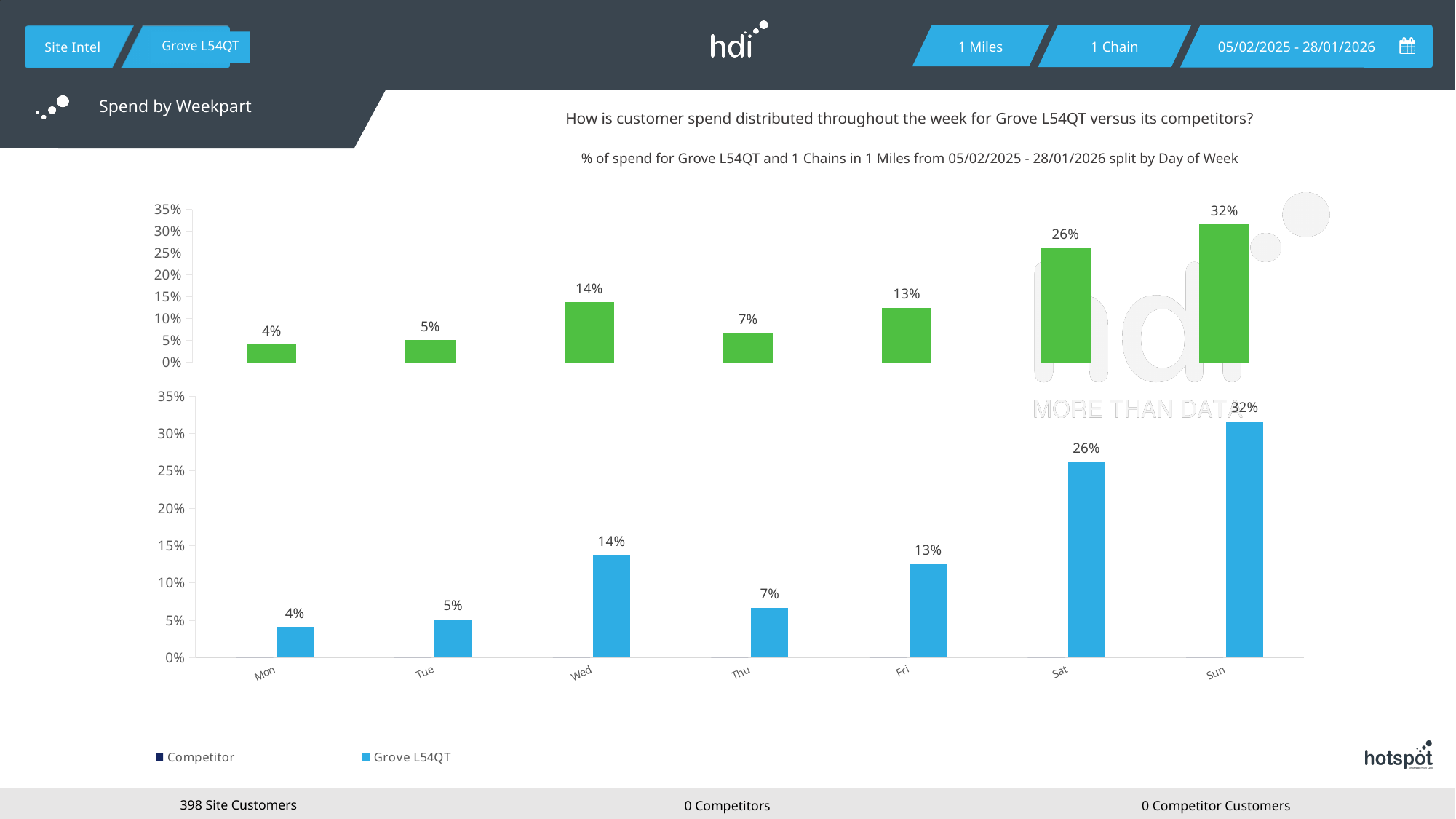
In the bottom chart, what is the value for Grove L54QT on Wed? 14% How many days of the week are shown on the x axis of the bottom chart? 7 What kind of chart is the bottom chart? Bar chart In the bottom chart, which day has the lowest value for Grove L54QT? Mon In the bottom chart, what is the value for Grove L54QT on Thu? 7% How many series does the legend at the bottom of the slide list? 2 In the bottom chart, which day has the highest value for Grove L54QT? Sun In the bottom chart, which is larger for Grove L54QT: Wed or Fri? Wed In the bottom chart, is the value for Grove L54QT on Sat greater or less than 20%? greater In the bottom chart, what is the value for Grove L54QT on Sun? 32% In the bottom chart, what is the difference between the Grove L54QT values for Sat and Fri? 13% What is the title of the slide shown in the top-left header? Spend by Weekpart